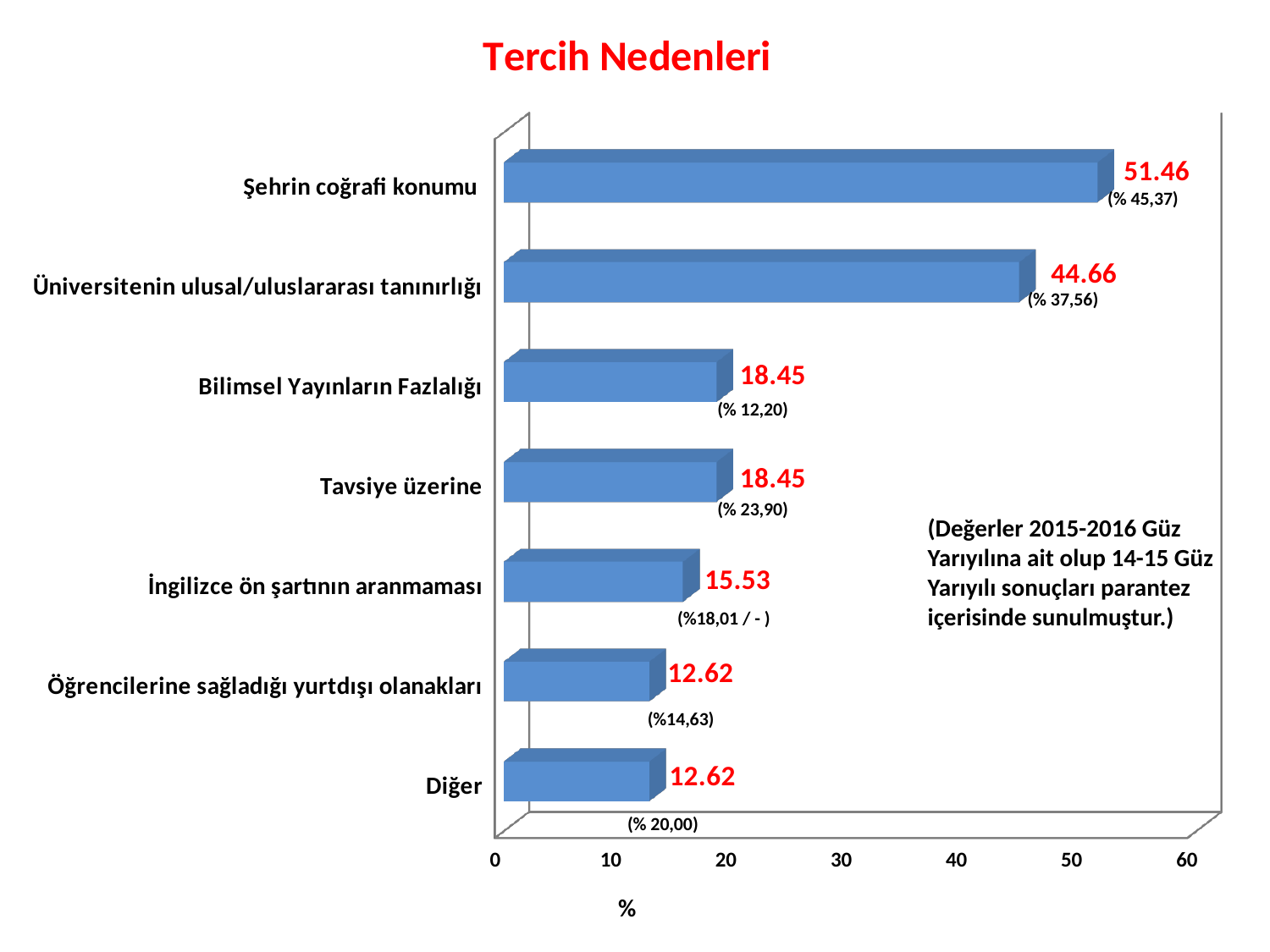
How many categories are shown in the chart? 7 What is the difference between the values for Şehrin coğrafi konumu and Üniversitenin ulusal/uluslararası tanınırlığı? 6.80 What is the value for Üniversitenin ulusal/uluslararası tanınırlığı? 44.66 What kind of chart is shown on the slide? bar chart Is the value for Üniversitenin ulusal/uluslararası tanınırlığı greater or less than 40? greater What is the difference between the values for Bilimsel Yayınların Fazlalığı and Öğrencilerine sağladığı yurtdışı olanakları? 5.83 What is the title of the chart? Tercih Nedenleri Which category has the highest value? Şehrin coğrafi konumu What is the value for İngilizce ön şartının aranmaması? 15.53 What is the value for Şehrin coğrafi konumu? 51.46 Which is larger, the value for Tavsiye üzerine or the value for İngilizce ön şartının aranmaması? Tavsiye üzerine What is the value for Diğer? 12.62